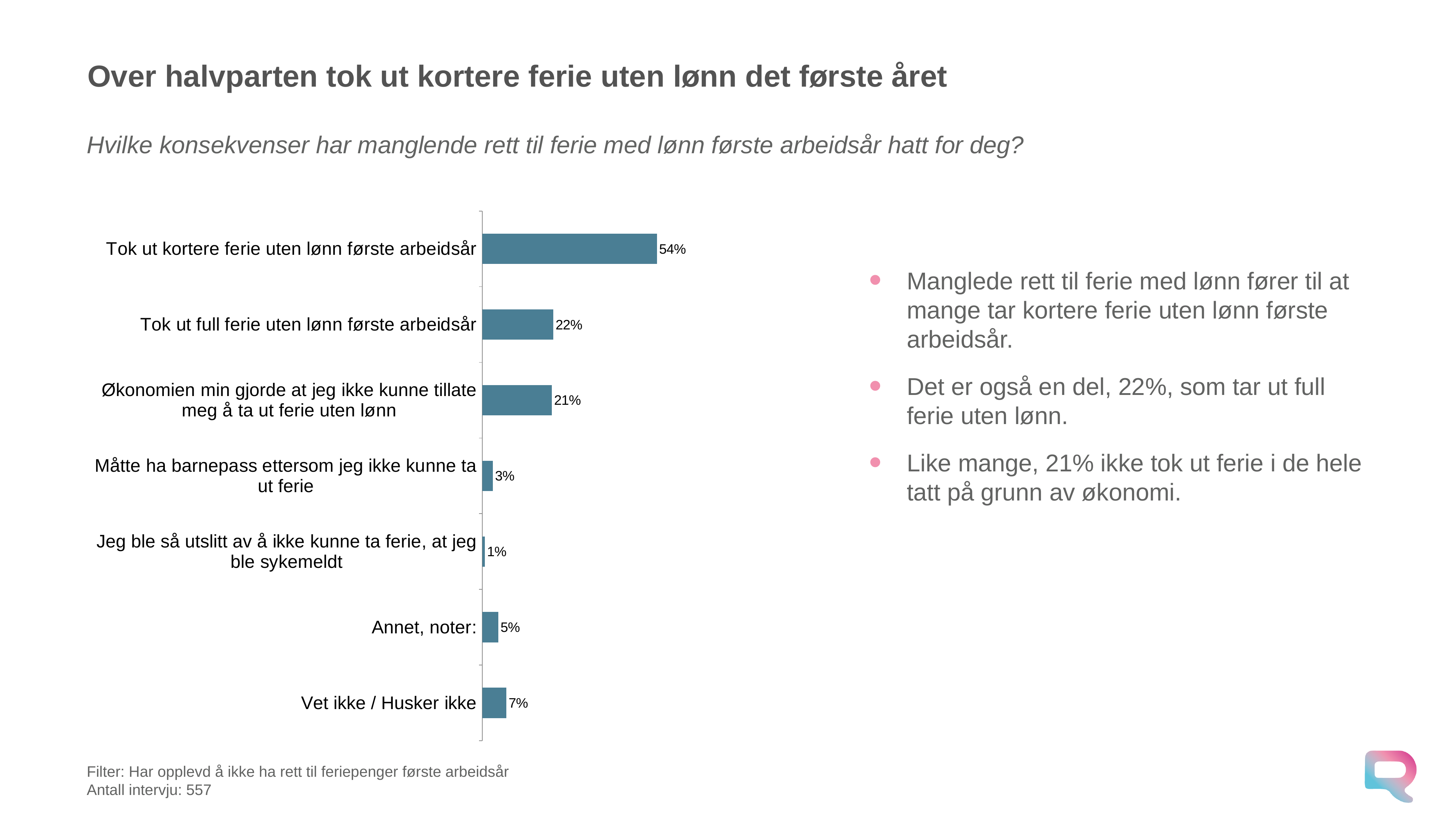
What is the value for "Vet ikke / Husker ikke"? 7% What is the difference between "Tok ut kortere ferie uten lønn første arbeidsår" and "Tok ut full ferie uten lønn første arbeidsår"? 32% What is the value for "Annet, noter:"? 5% What kind of chart is shown on the slide? Bar chart Which category has the lowest value? Jeg ble så utslitt av å ikke kunne ta ferie, at jeg ble sykemeldt Which is larger: "Vet ikke / Husker ikke" or "Annet, noter:"? Vet ikke / Husker ikke How many categories are shown in the chart? 7 What is the difference between "Måtte ha barnepass ettersom jeg ikke kunne ta ut ferie" and "Jeg ble så utslitt av å ikke kunne ta ferie, at jeg ble sykemeldt"? 2% What is the value for "Tok ut kortere ferie uten lønn første arbeidsår"? 54% Which category has the highest value? Tok ut kortere ferie uten lønn første arbeidsår What is the number of interviews (Antall intervju) stated on the slide? 557 What is the value for "Tok ut full ferie uten lønn første arbeidsår"? 22%